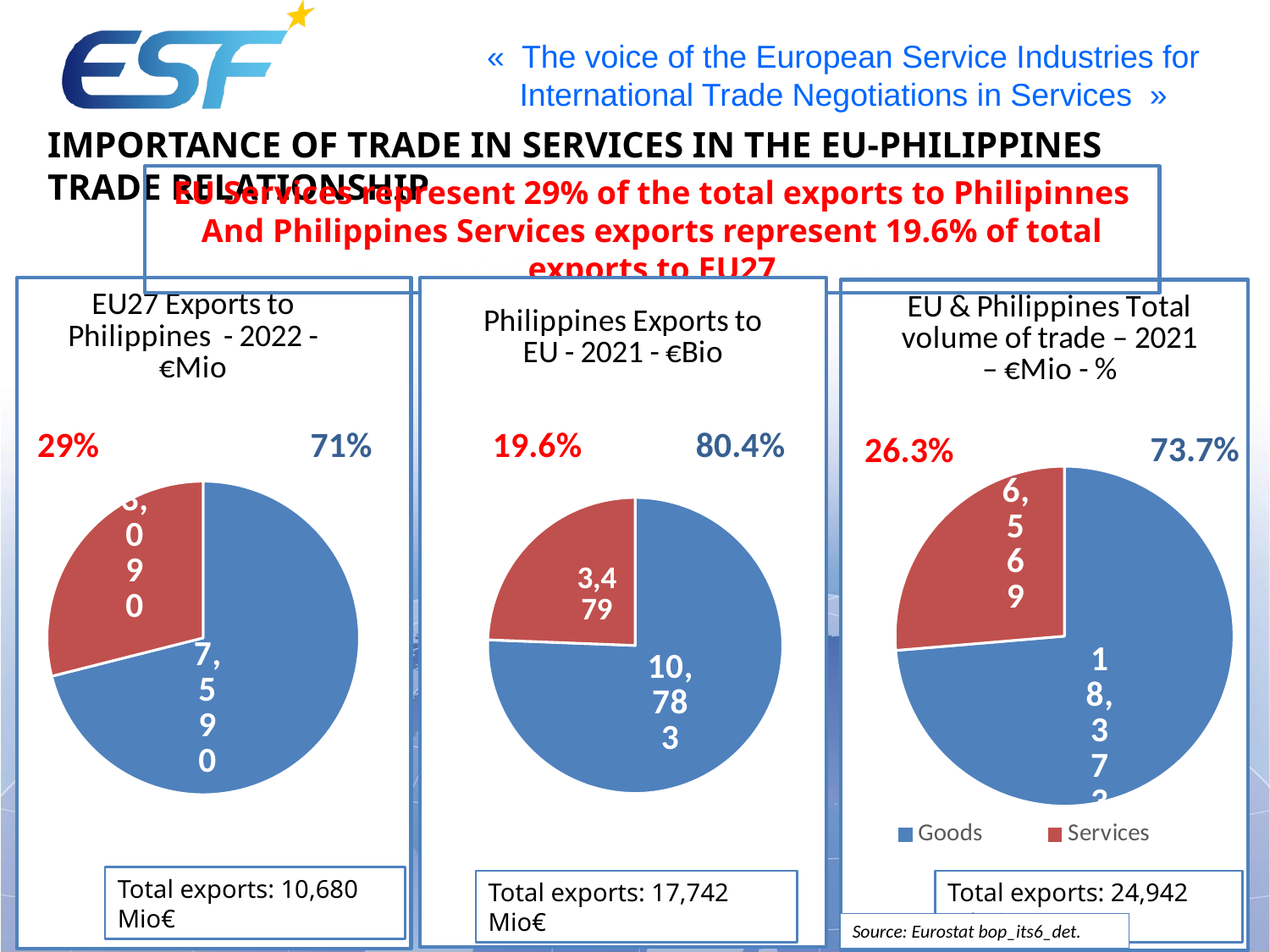
In the 'EU27 Exports to Philippines - 2022 - €Mio' chart, what value is labelled on the blue (Goods) slice? 7,590 In the 'Philippines Exports to EU - 2021 - €Bio' chart, what share does the blue slice represent? 80.4% In the 'EU27 Exports to Philippines - 2022 - €Mio' chart, what share does the blue (Goods) slice represent? 71% In the 'EU & Philippines Total volume of trade – 2021' chart, what share does Services represent? 26.3% How many slices does the 'Philippines Exports to EU - 2021 - €Bio' pie chart have? 2 In the 'Philippines Exports to EU - 2021 - €Bio' chart, what value is labelled on the red slice? 3,479 In the 'EU & Philippines Total volume of trade – 2021' chart, which slice is larger, Goods or Services? Goods In the 'EU & Philippines Total volume of trade – 2021' chart, what value is labelled on the Services slice? 6,569 How many entries does the legend of the 'EU & Philippines Total volume of trade – 2021' chart list? 2 What kind of chart is used in the 'EU27 Exports to Philippines - 2022 - €Mio' chart? pie chart In the 'Philippines Exports to EU - 2021 - €Bio' chart, what value is labelled on the blue slice? 10,783